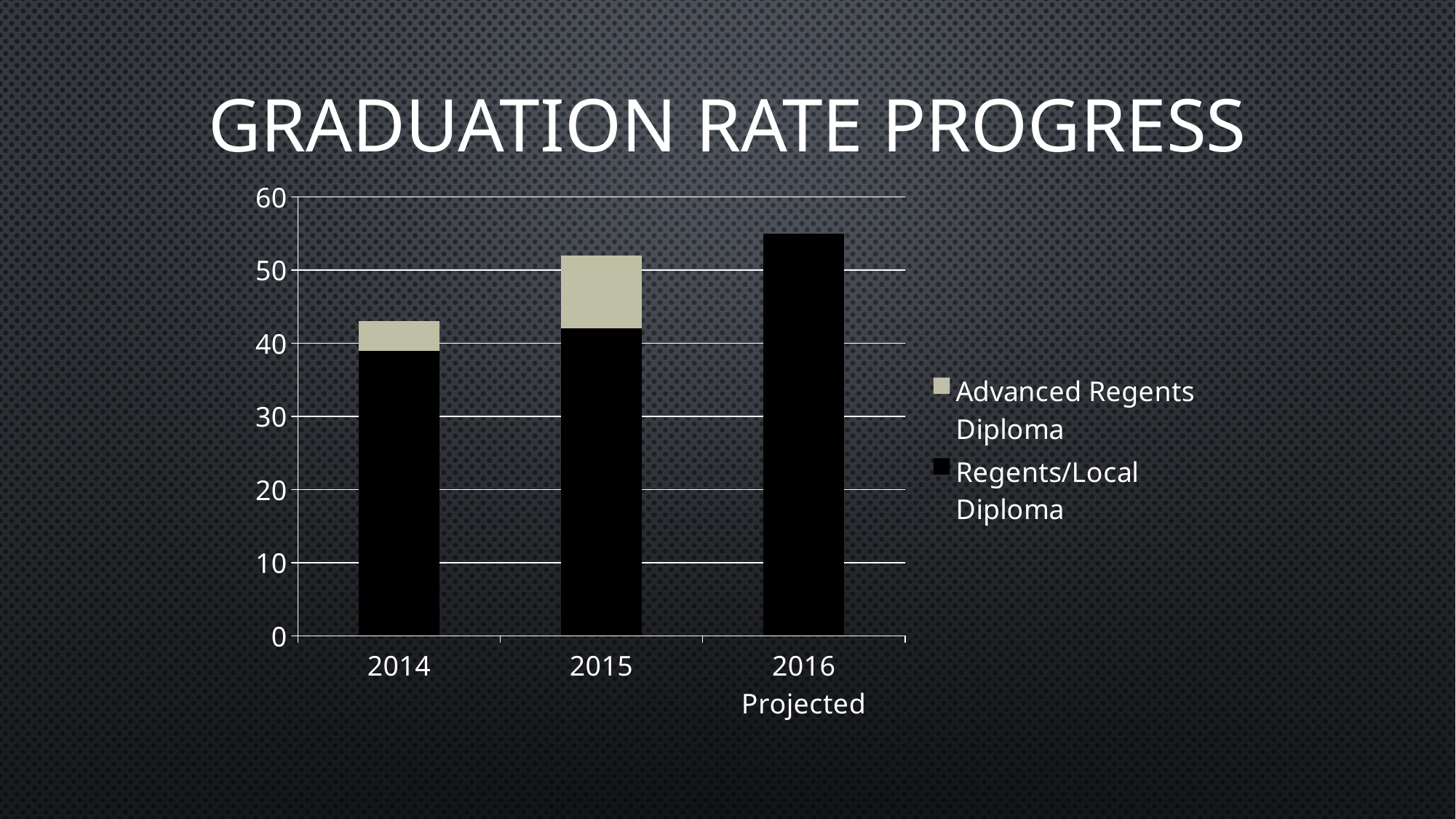
Is the total bar height for 2016 Projected greater or less than 50? greater Which category has the tallest bar overall? 2016 Projected Is the total bar height for 2014 greater or less than 50? less What kind of chart is shown on the slide? Stacked bar chart Is the total bar height for 2016 Projected greater or less than 60? less Which category has the shortest bar overall? 2014 Which is larger, the Regents/Local Diploma value for 2015 or for 2016 Projected? 2016 Projected How many categories are shown on the x axis? 3 Do the total bar heights rise or fall from 2014 to 2016 Projected? Rise Which series is shown in black in the legend? Regents/Local Diploma What is the title of the chart? Graduation Rate Progress How many series does the legend list? 2